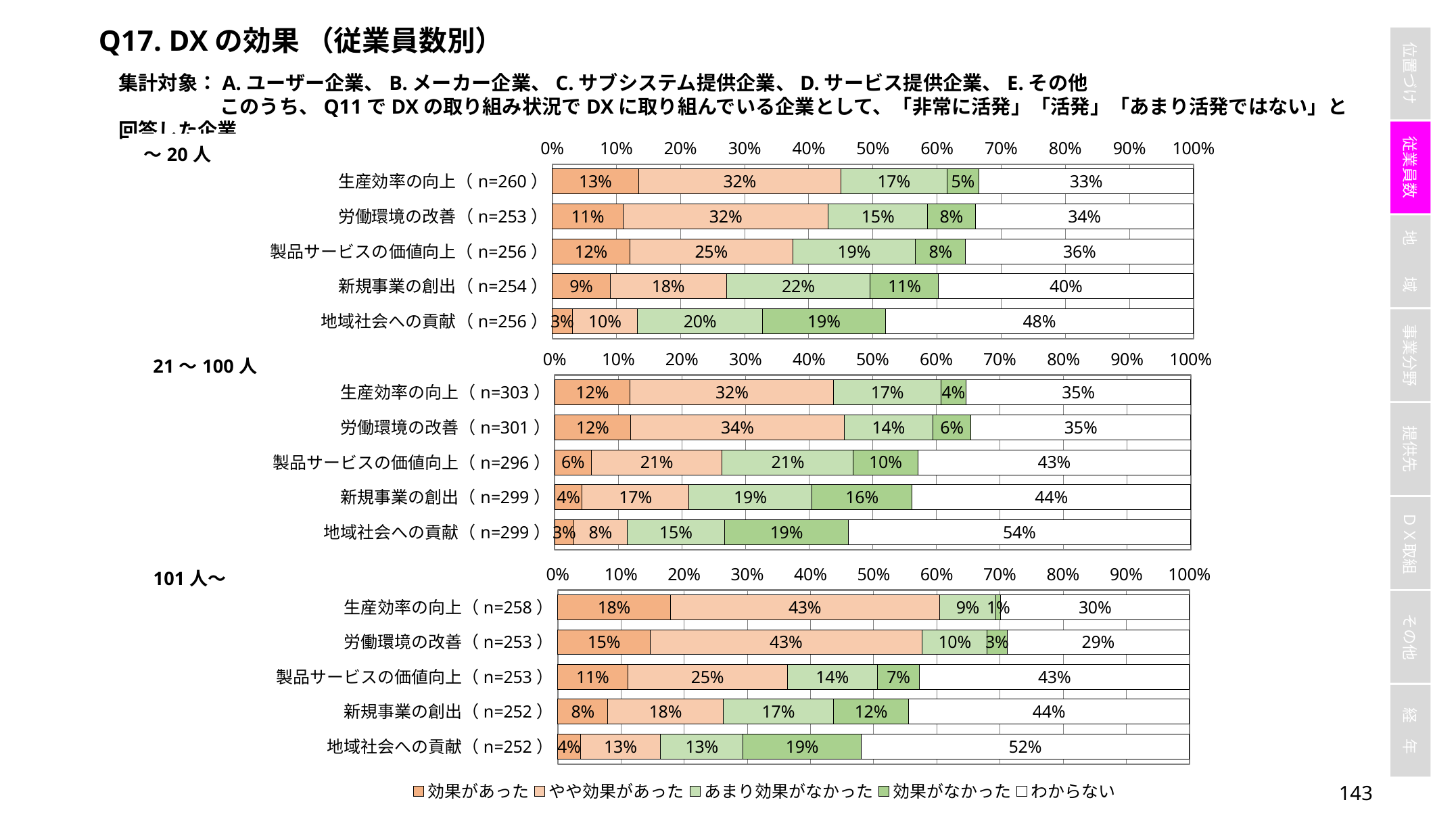
In the ～20人 chart, which category has the lowest percentage for わからない? 生産効率の向上 In the 101人～ chart, which category has the highest percentage for 効果があった? 生産効率の向上 In the ～20人 chart, what percentage of respondents answered 効果があった for 生産効率の向上? 13% How many categories are plotted in the 21～100人 chart? 5 What is the sample size (n) shown for 生産効率の向上 in the 21～100人 chart? 303 In the ～20人 chart, what is the combined percentage of 効果があった and やや効果があった for 労働環境の改善? 43% In the 101人～ chart, which is larger: the 効果がなかった percentage for 地域社会への貢献 or for 新規事業の創出? 地域社会への貢献 In the 21～100人 chart, what percentage answered わからない for 地域社会への貢献? 54% In the 101人～ chart, what percentage answered やや効果があった for 労働環境の改善? 43% What kind of chart is used for the ～20人 group? Stacked bar chart In the 21～100人 chart, what is the difference between the わからない percentages for 新規事業の創出 and 生産効率の向上? 9% How many series does the legend at the bottom of the slide list? 5